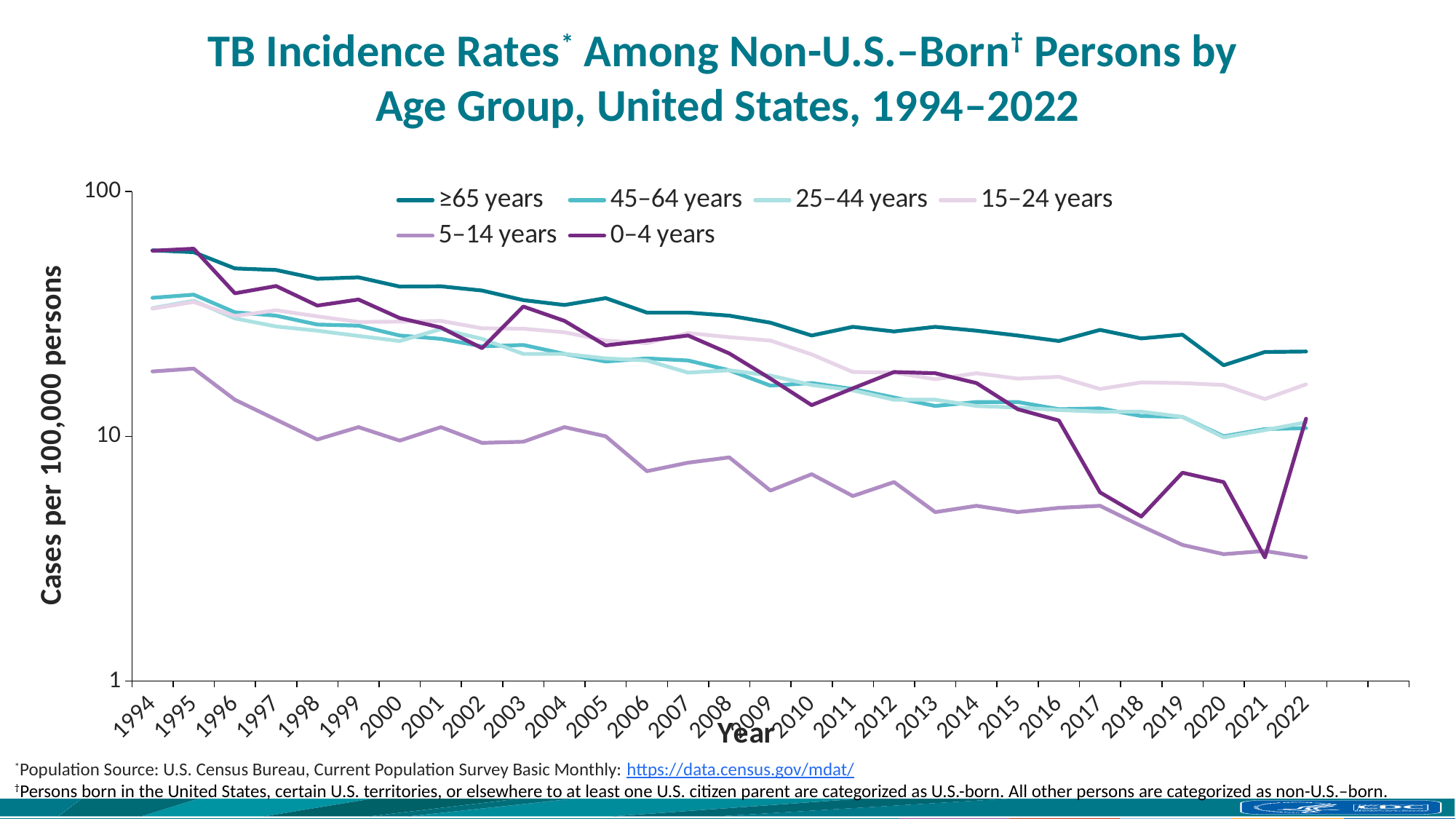
What is the label on the y axis? Cases per 100,000 persons How many years are plotted along the x axis? 29 Is the value for 5–14 years in 2022 greater or less than 10? less Which age group has the lowest TB incidence rate in 2010? 5–14 years Does the TB incidence rate for ≥65 years generally rise or fall from 1994 to 2022? Fall In 2010, which is larger: the rate for ≥65 years or the rate for 0–4 years? ≥65 years Which age group has the highest TB incidence rate in 2022? ≥65 years How many age-group series does the legend list? 6 What kind of chart is shown on the slide? Line chart Which age group has the lowest TB incidence rate in 2022? 5–14 years Is the value for 0–4 years in 2021 greater or less than 10? less Is the value for ≥65 years in 2022 greater or less than 10? greater